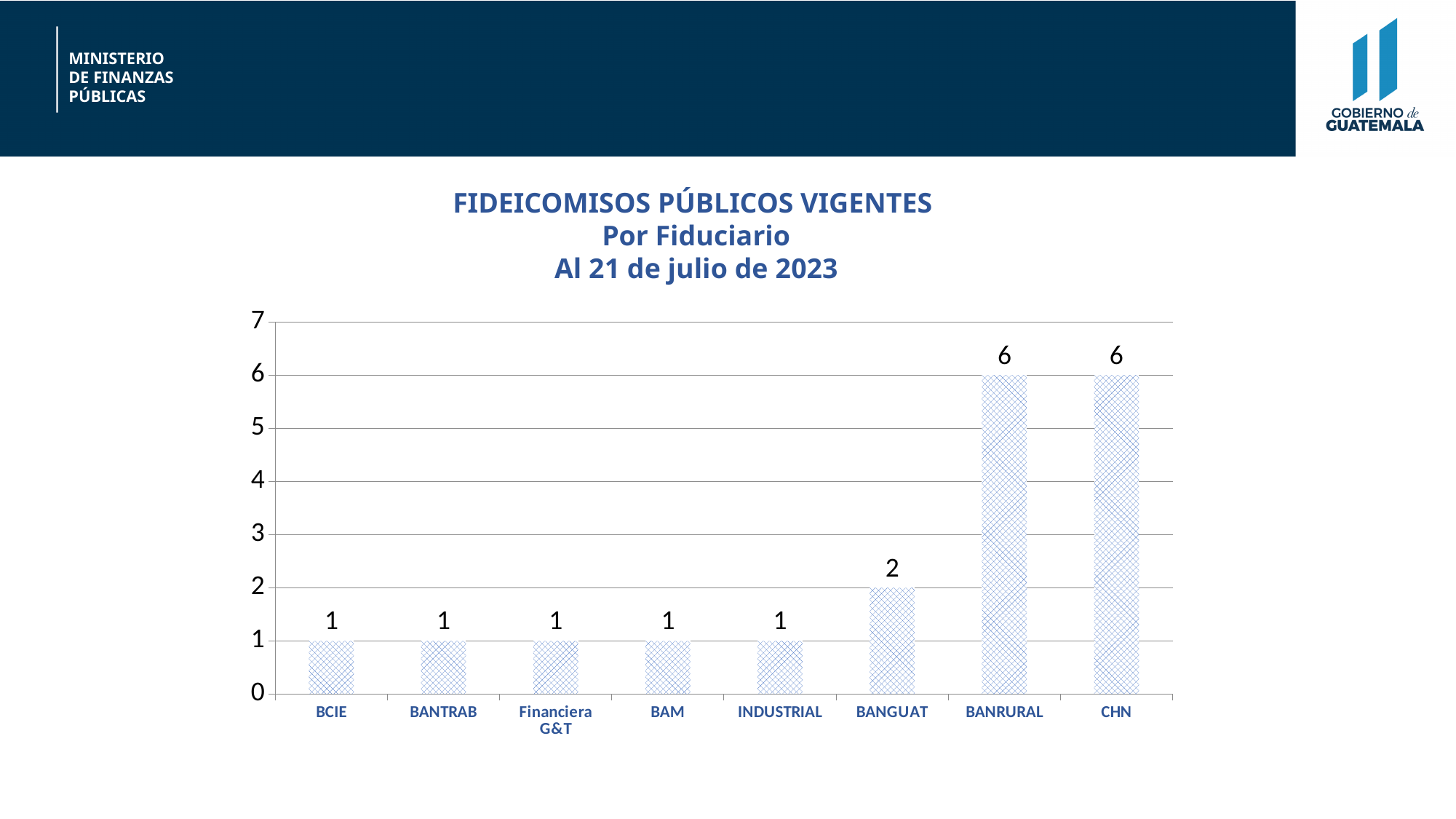
What is the difference between the values for BANRURAL and BANGUAT? 4 Which categories have the highest value? BANRURAL and CHN What kind of chart is shown on the slide? bar chart Which is larger, the value for CHN or the value for BANGUAT? CHN How many categories are shown on the x axis? 8 What is the date given in the chart title? Al 21 de julio de 2023 Is the value for BANRURAL greater or less than 4? greater What is the value for BANGUAT? 2 What is the difference between the values for BANGUAT and BCIE? 1 What is the value for Financiera G&T? 1 What is the value for INDUSTRIAL? 1 What is the value for BANRURAL? 6